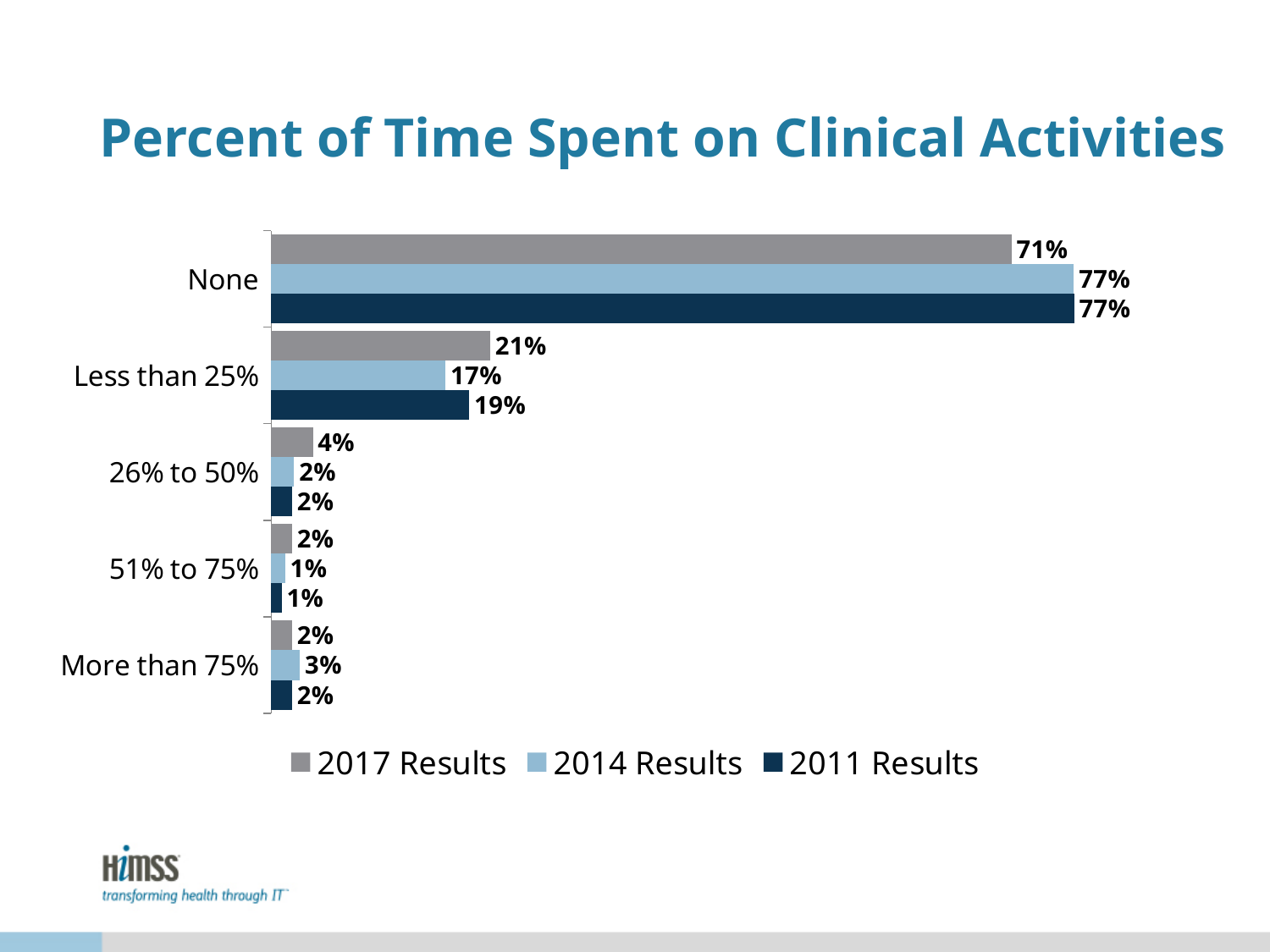
What is the 2017 Results value for the 'None' category? 71% For 'Less than 25%', which is larger: the 2017 Results value or the 2011 Results value? 2017 Results What is the difference between the 2014 Results and 2017 Results values for 'None'? 6% What is the 2011 Results value for '26% to 50%'? 2% Which category has the highest 2017 Results value? None Which series is shown in the darkest blue colour? 2011 Results Which category has the lowest 2011 Results value? 51% to 75% How many series does the legend list? 3 What kind of chart is shown on the slide? Bar chart What is the title of the chart? Percent of Time Spent on Clinical Activities How many categories are shown on the chart? 5 What is the 2014 Results value for 'Less than 25%'? 17%